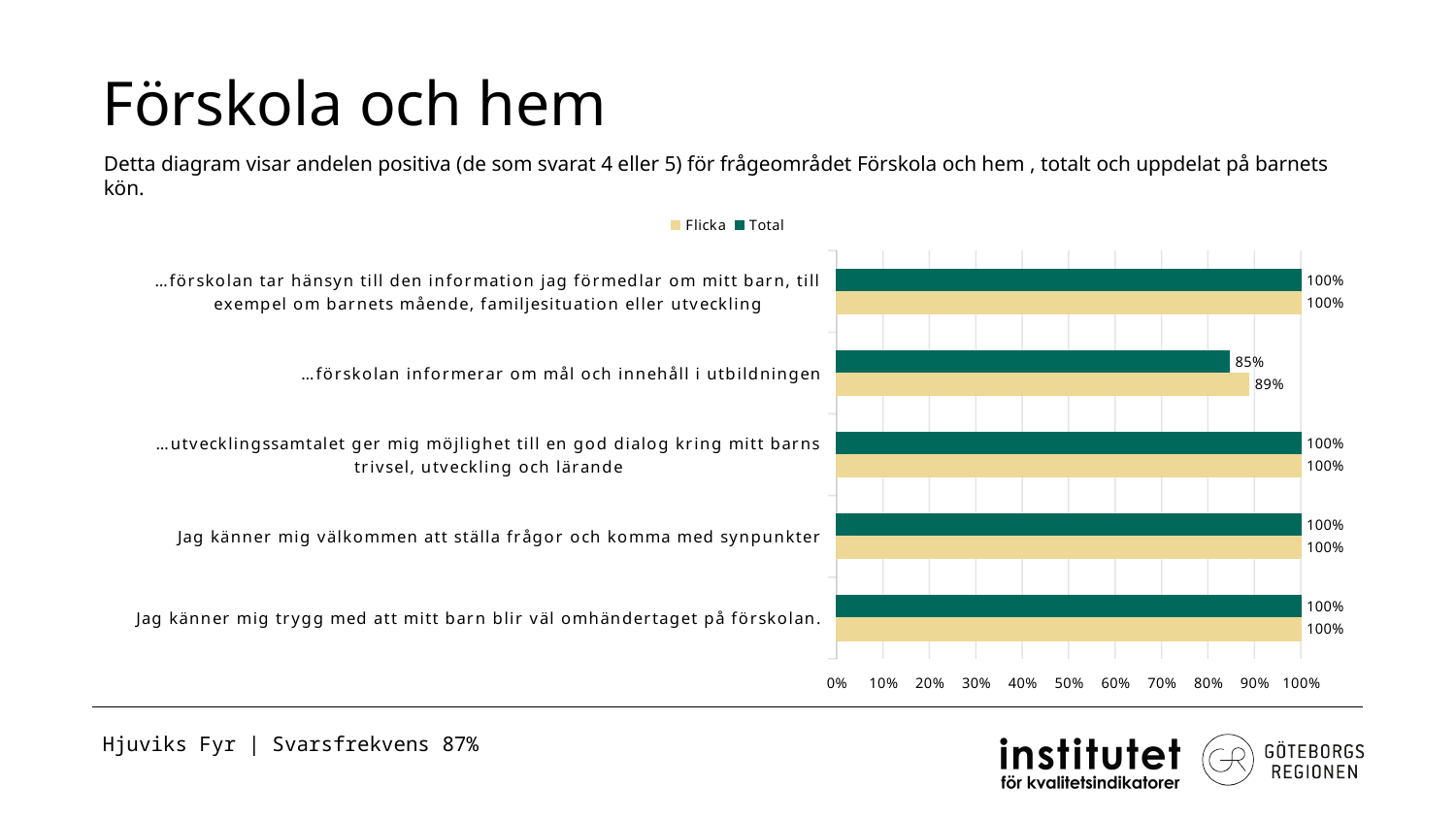
What is the difference between the Flicka and Total values for "…förskolan informerar om mål och innehåll i utbildningen"? 4% Is the Total value for "…förskolan informerar om mål och innehåll i utbildningen" greater or less than 90%? less For "…förskolan informerar om mål och innehåll i utbildningen", which is larger, the Flicka value or the Total value? Flicka What is the Flicka value for "…förskolan informerar om mål och innehåll i utbildningen"? 89% Which category has the lowest Total value? …förskolan informerar om mål och innehåll i utbildningen Which series is shown in dark green in the legend? Total What is the Total value for "Jag känner mig trygg med att mitt barn blir väl omhändertaget på förskolan."? 100% How many categories (statements) are plotted in the chart? 5 What is the Total value for "…förskolan informerar om mål och innehåll i utbildningen"? 85% How many series does the legend list? 2 What is the Flicka value for "Jag känner mig välkommen att ställa frågor och komma med synpunkter"? 100% What kind of chart is shown on the slide? bar chart